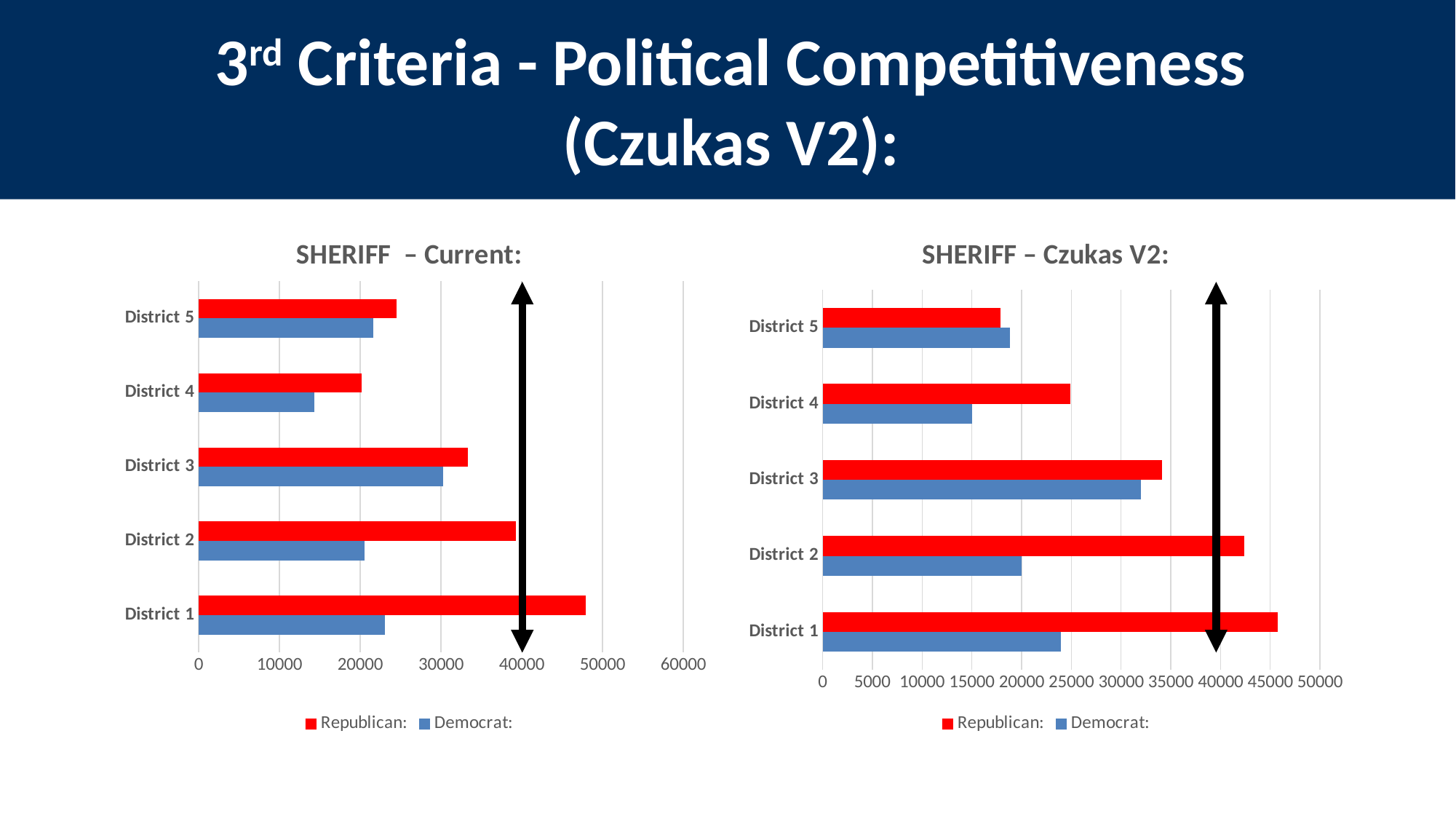
How many series does the legend of the SHERIFF – Current chart list? 2 How many districts are shown in the SHERIFF – Czukas V2 chart? 5 In the SHERIFF – Czukas V2 chart, is the Republican value for District 2 greater or less than 40000? greater In the SHERIFF – Czukas V2 chart, which district has the highest Republican value? District 1 What kind of chart is the SHERIFF – Current chart? Bar chart In the SHERIFF – Czukas V2 chart, which district has the lowest Republican value? District 5 In the SHERIFF – Current chart, which district has the highest Republican value? District 1 In the SHERIFF – Czukas V2 chart, is the Democrat value for District 4 greater or less than 20000? less In the SHERIFF – Current chart, is the Republican value for District 1 greater or less than 40000? greater In the SHERIFF – Current chart, which is larger for District 2, the Republican value or the Democrat value? Republican In the SHERIFF – Current chart, which district has the lowest Democrat value? District 4